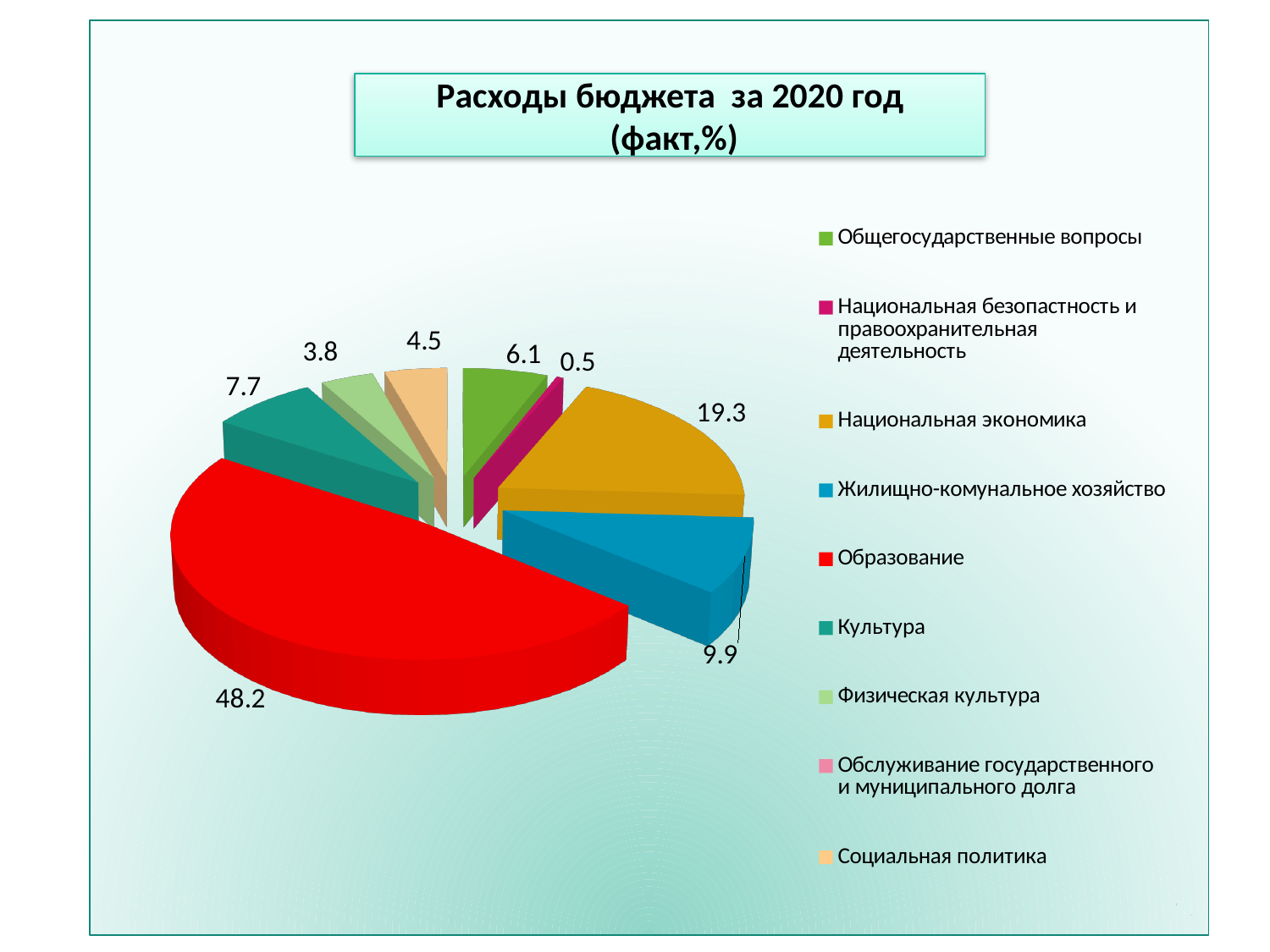
What is the difference between the values for Образование and Национальная экономика? 28.9 Which is larger, the value for Общегосударственные вопросы or the value for Физическая культура? Общегосударственные вопросы What is the title of the chart? Расходы бюджета за 2020 год (факт,%) Which labelled slice has the smallest value? Национальная безопастность и правоохранительная деятельность What is the value for Национальная экономика? 19.3 What is the value for Образование? 48.2 What kind of chart is shown on the slide? pie chart What is the value for Культура? 7.7 What is the value for Социальная политика? 4.5 How many entries does the legend list? 9 What is the value for Жилищно-комунальное хозяйство? 9.9 Which category has the largest share of the pie? Образование